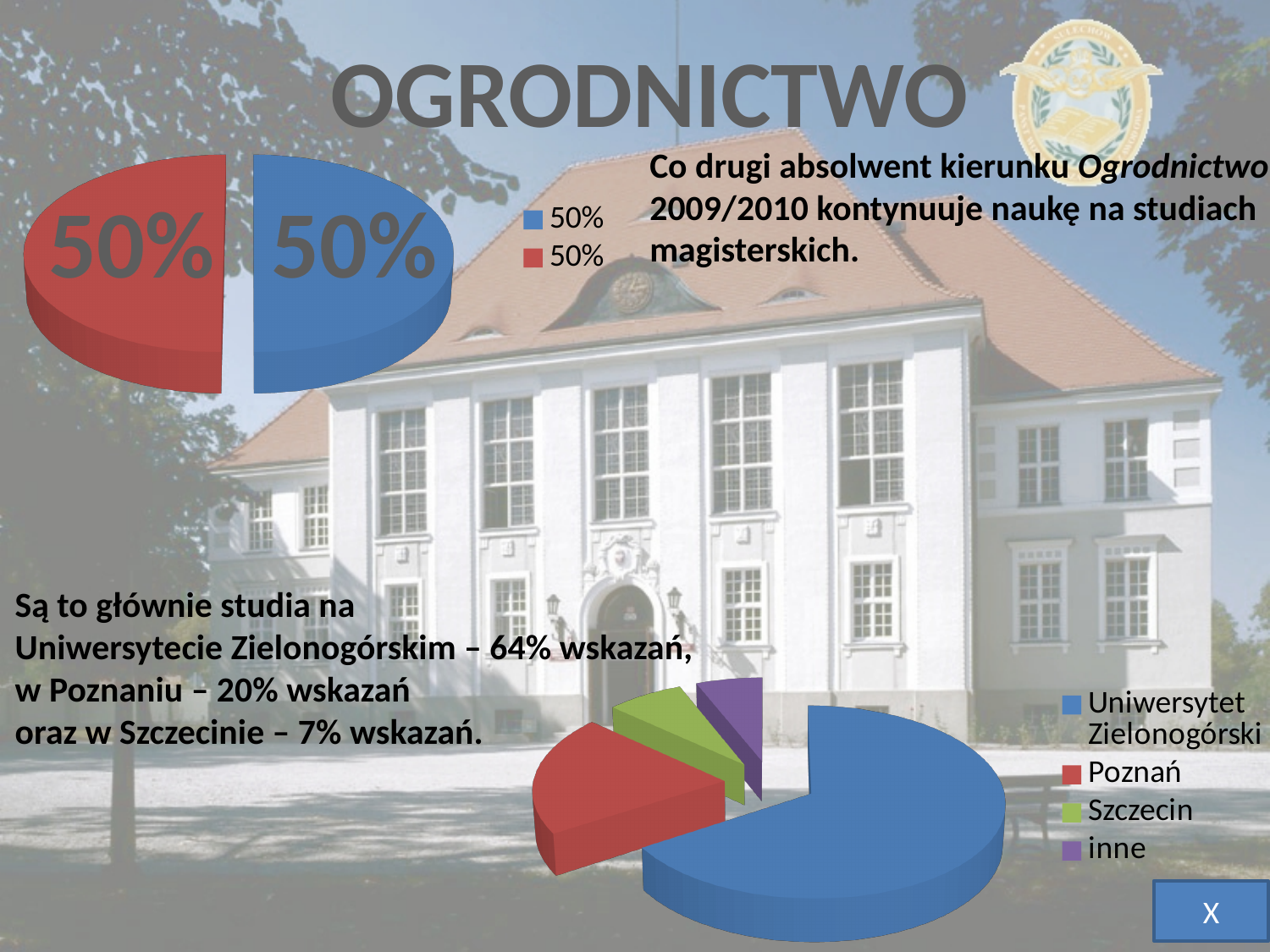
How many slices does the bottom pie chart have? 4 How many entries does the legend of the bottom pie chart list? 4 In the bottom pie chart, what colour is the slice for Szczecin? green In the bottom pie chart, which is larger, the slice for Uniwersytet Zielonogórski or the slice for Poznań? Uniwersytet Zielonogórski In the bottom pie chart, which is larger, the slice for Poznań or the slice for Szczecin? Poznań What kind of chart is the bottom chart on the slide? pie chart In the top-left pie chart, what share does the red slice have? 50% How many slices does the top-left pie chart have? 2 In the bottom pie chart, what colour is the slice for inne? purple What kind of chart is the top-left chart on the slide? pie chart In the top-left pie chart, what share does the blue slice have? 50% In the bottom pie chart, which category has the largest slice? Uniwersytet Zielonogórski